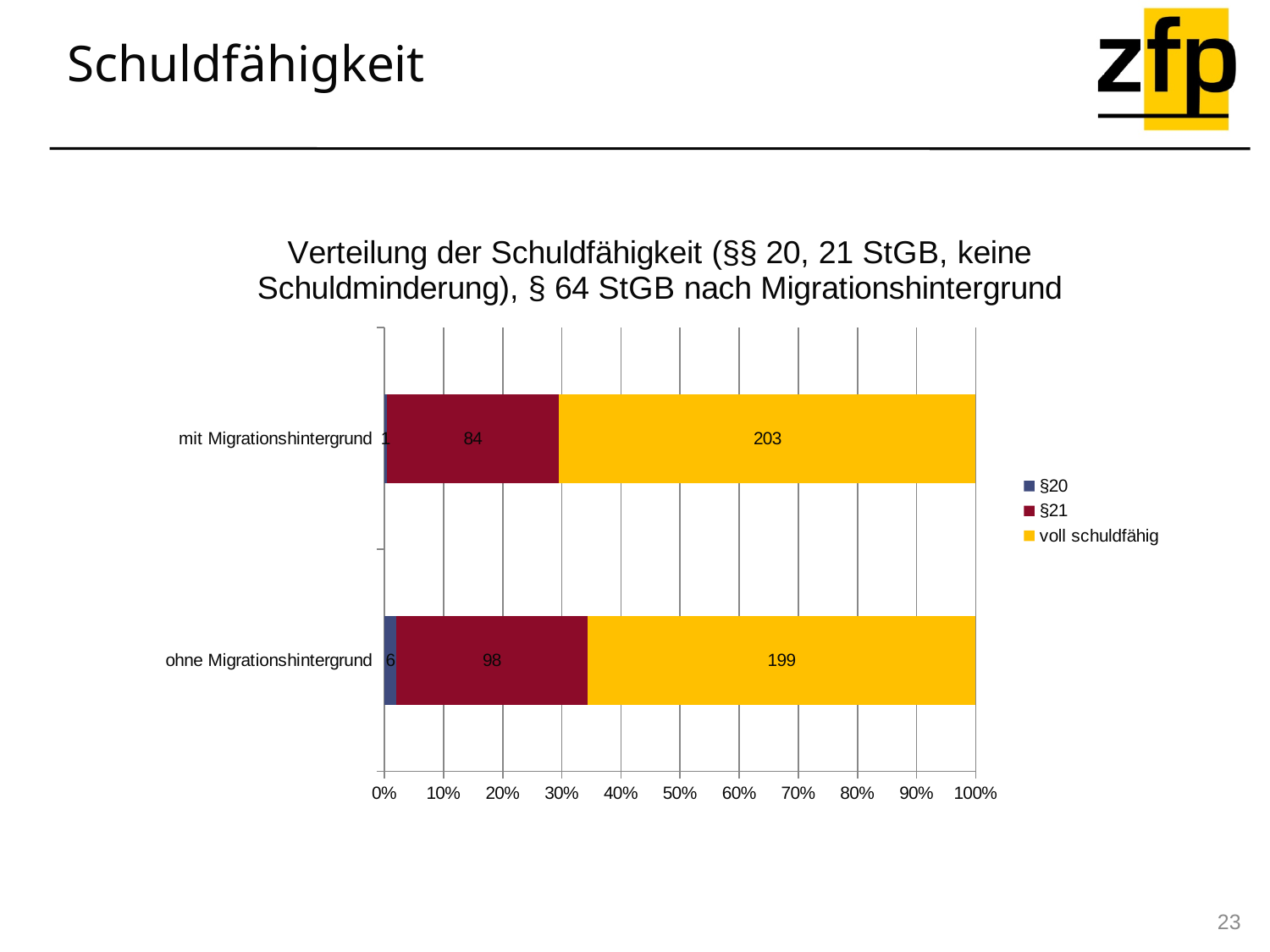
How many series does the legend list? 3 What is the value for 'voll schuldfähig' in the 'ohne Migrationshintergrund' bar? 199 What is the value for §20 in the 'ohne Migrationshintergrund' bar? 6 Which colour represents 'voll schuldfähig' in the chart? Yellow What is the value for §21 in the 'mit Migrationshintergrund' bar? 84 How many categories are shown on the chart? 2 What kind of chart is shown on the slide? Stacked bar chart What is the total of the 'ohne Migrationshintergrund' bar? 303 What is the difference between the §21 values for 'ohne Migrationshintergrund' and 'mit Migrationshintergrund'? 14 What is the total of the 'mit Migrationshintergrund' bar? 288 Which category has the higher §21 value, 'mit Migrationshintergrund' or 'ohne Migrationshintergrund'? ohne Migrationshintergrund What is the value for 'voll schuldfähig' in the 'mit Migrationshintergrund' bar? 203